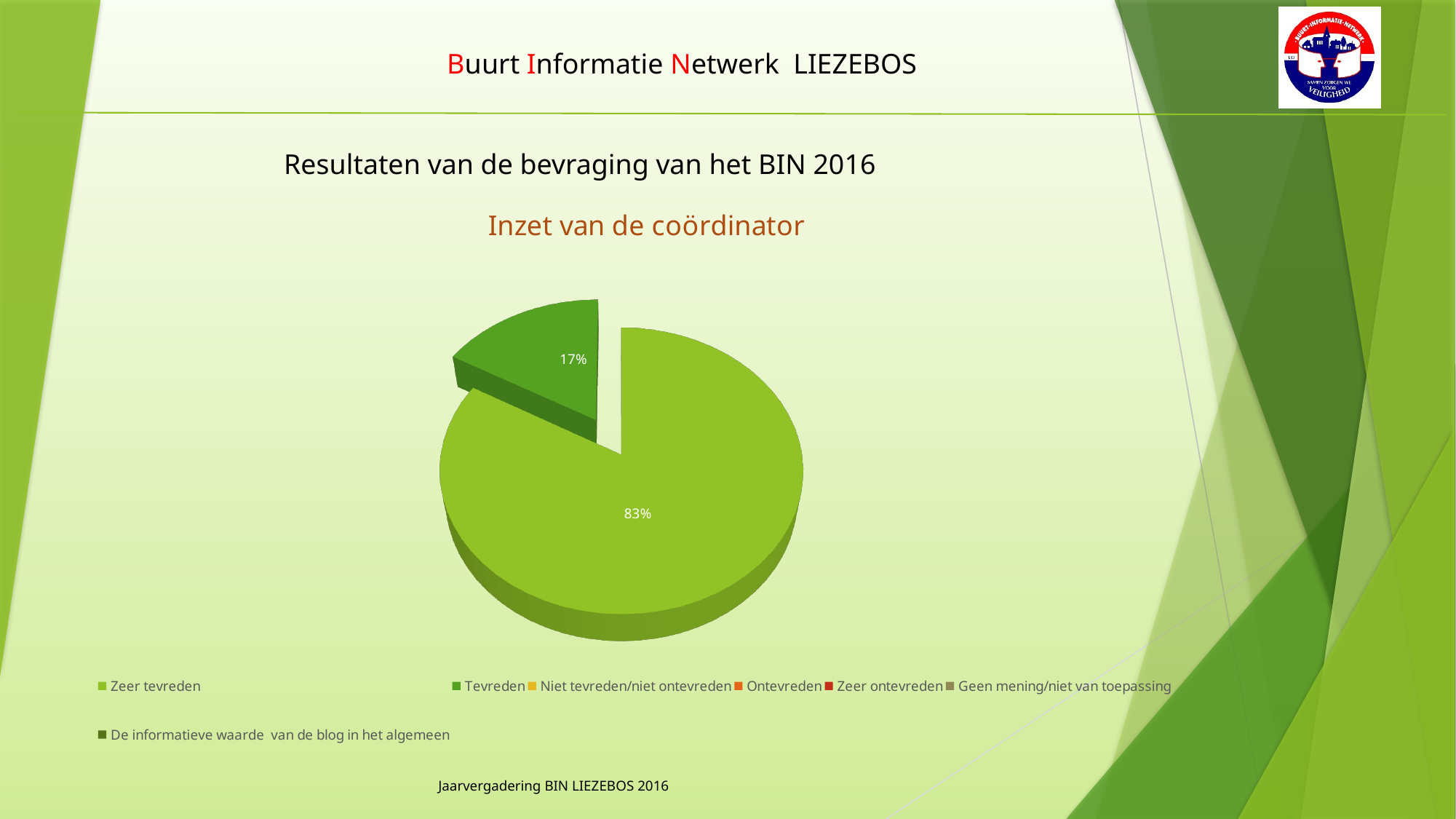
Which slice is larger, 'Zeer tevreden' or 'Tevreden'? Zeer tevreden How many slices with data labels are visible in the pie? 2 Which category has the largest slice of the pie? Zeer tevreden What is the difference in percentage points between the 'Zeer tevreden' slice and the 'Tevreden' slice? 66 What percentage of the pie is labelled for the 'Zeer tevreden' slice? 83% Is the share for 'Zeer tevreden' greater or less than 50%? greater Which of the two labelled slices is the smallest? Tevreden What percentage of the pie is labelled for the 'Tevreden' slice? 17% What share of the pie does the 'Tevreden' slice represent? 17% How many entries does the legend list? 7 What is the chart's title? Inzet van de coördinator What kind of chart is shown on the slide? pie chart